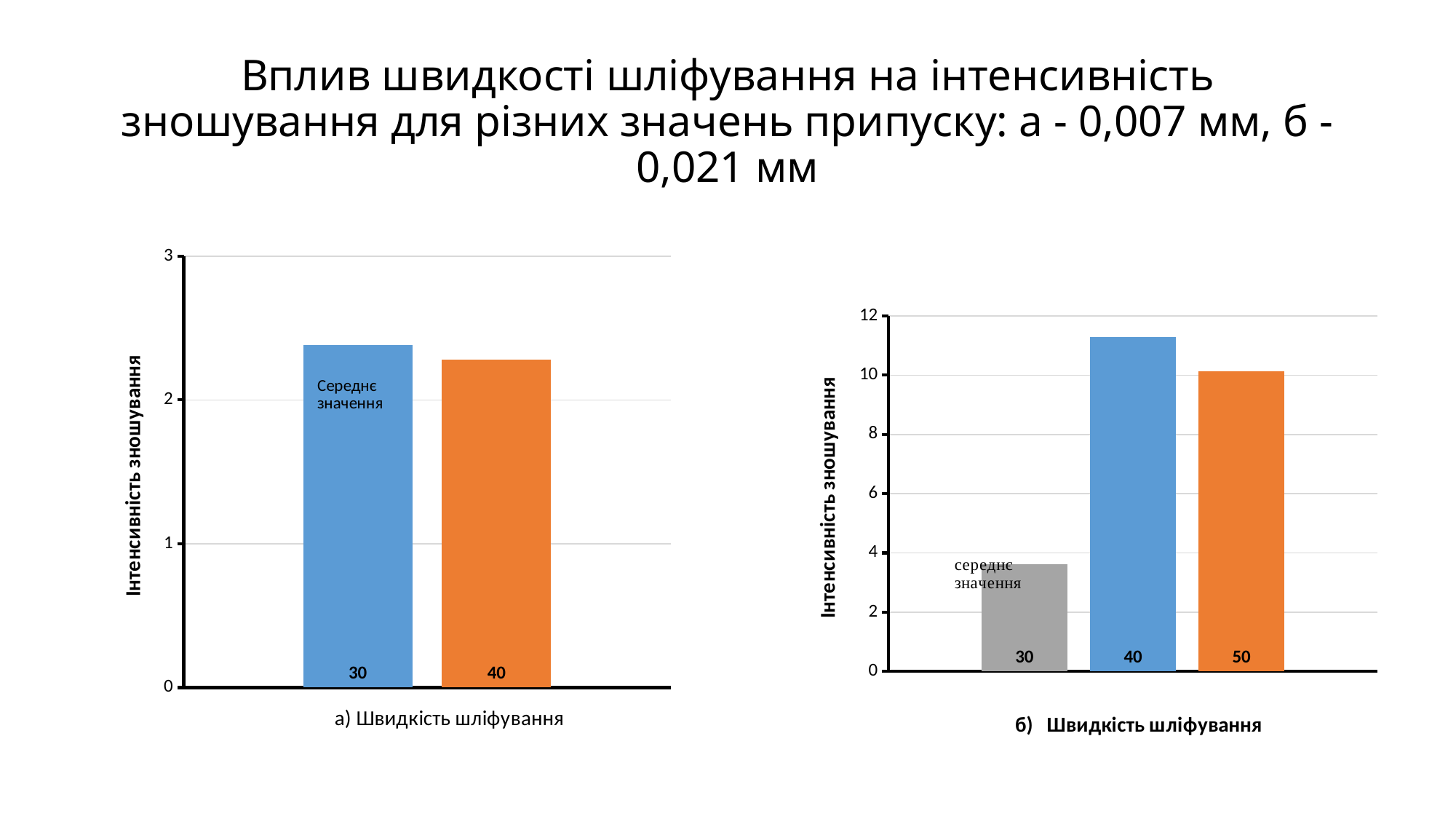
How many bars are plotted in the left chart (а)? 2 In the right chart (б), is the value for 50 greater or less than 8? greater In the right chart (б), which grinding speed has the highest wear intensity? 40 In the right chart (б), which grinding speed has the lowest wear intensity? 30 In the left chart (а), is the value for 30 greater or less than 2? greater In the left chart (а), which bar is taller, 30 or 40? 30 In the right chart (б), which bar is taller, 40 or 50? 40 What kind of chart is the left chart (а)? bar chart In the right chart (б), is the value for 30 greater or less than 4? less How many bars are plotted in the right chart (б)? 3 What is the y-axis label of the right chart (б)? Інтенсивність зношування